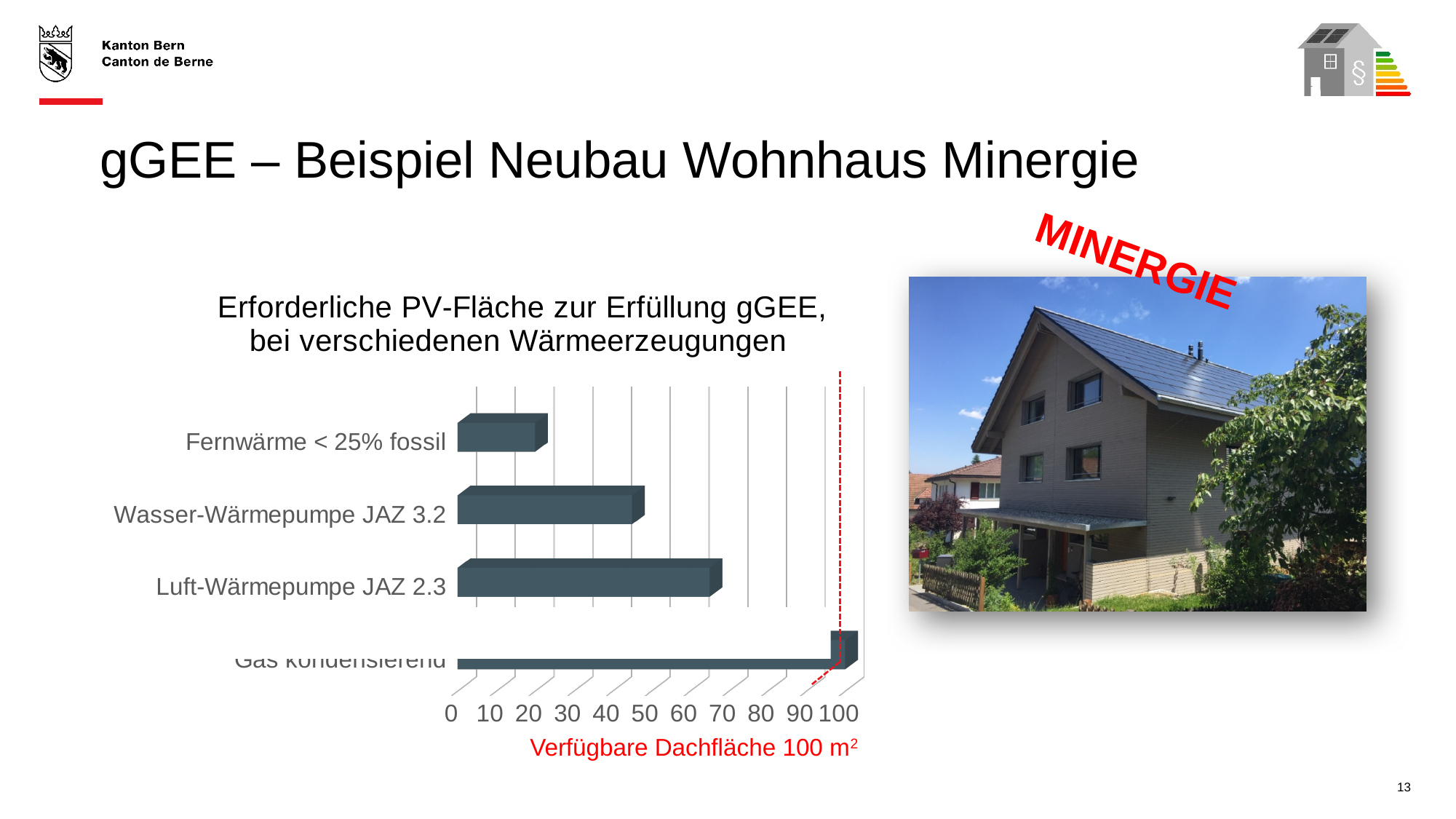
Which category requires the smallest PV area? Fernwärme < 25% fossil Is the value for Luft-Wärmepumpe JAZ 2.3 greater or less than 80? less Which requires more PV area: Fernwärme < 25% fossil or Wasser-Wärmepumpe JAZ 3.2? Wasser-Wärmepumpe JAZ 3.2 Is the value for Gas kondensierend greater or less than 90? greater What is the title of the chart? Erforderliche PV-Fläche zur Erfüllung gGEE, bei verschiedenen Wärmeerzeugungen What kind of chart is shown on the slide? bar chart How many categories (heat generation types) are shown in the chart? 4 What does the red dashed vertical line in the chart mark? Verfügbare Dachfläche 100 m² Which category requires the largest PV area? Gas kondensierend Which requires more PV area: Luft-Wärmepumpe JAZ 2.3 or Wasser-Wärmepumpe JAZ 3.2? Luft-Wärmepumpe JAZ 2.3 Is the value for Fernwärme < 25% fossil greater or less than 30? less